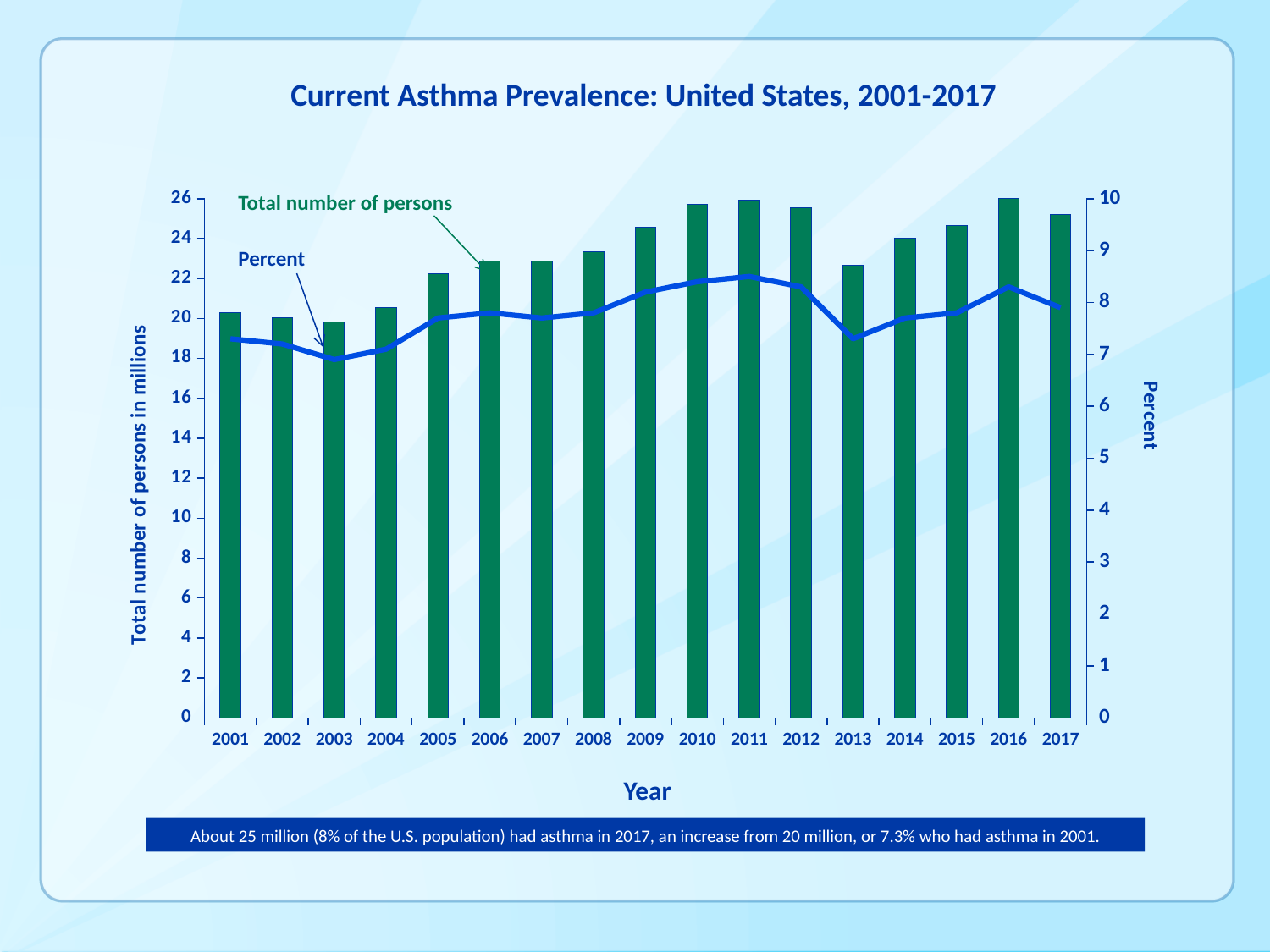
What is the label of the left vertical axis? Total number of persons in millions Is the percent value for 2011 greater or less than 8? greater What kind of chart is shown on the slide? A bar chart combined with a line How many data series are plotted on the chart? 2 How many years are plotted along the x axis of the chart? 17 Is the total number of persons bar for 2013 greater or less than 24 million? less Which year has the lowest percent value on the line? 2003 Is the percent value for 2003 greater or less than 8? less Overall, does the total number of persons with asthma rise or fall from 2001 to 2017? rise Which year has a taller total number of persons bar, 2010 or 2013? 2010 What is the title of the chart? Current Asthma Prevalence: United States, 2001-2017